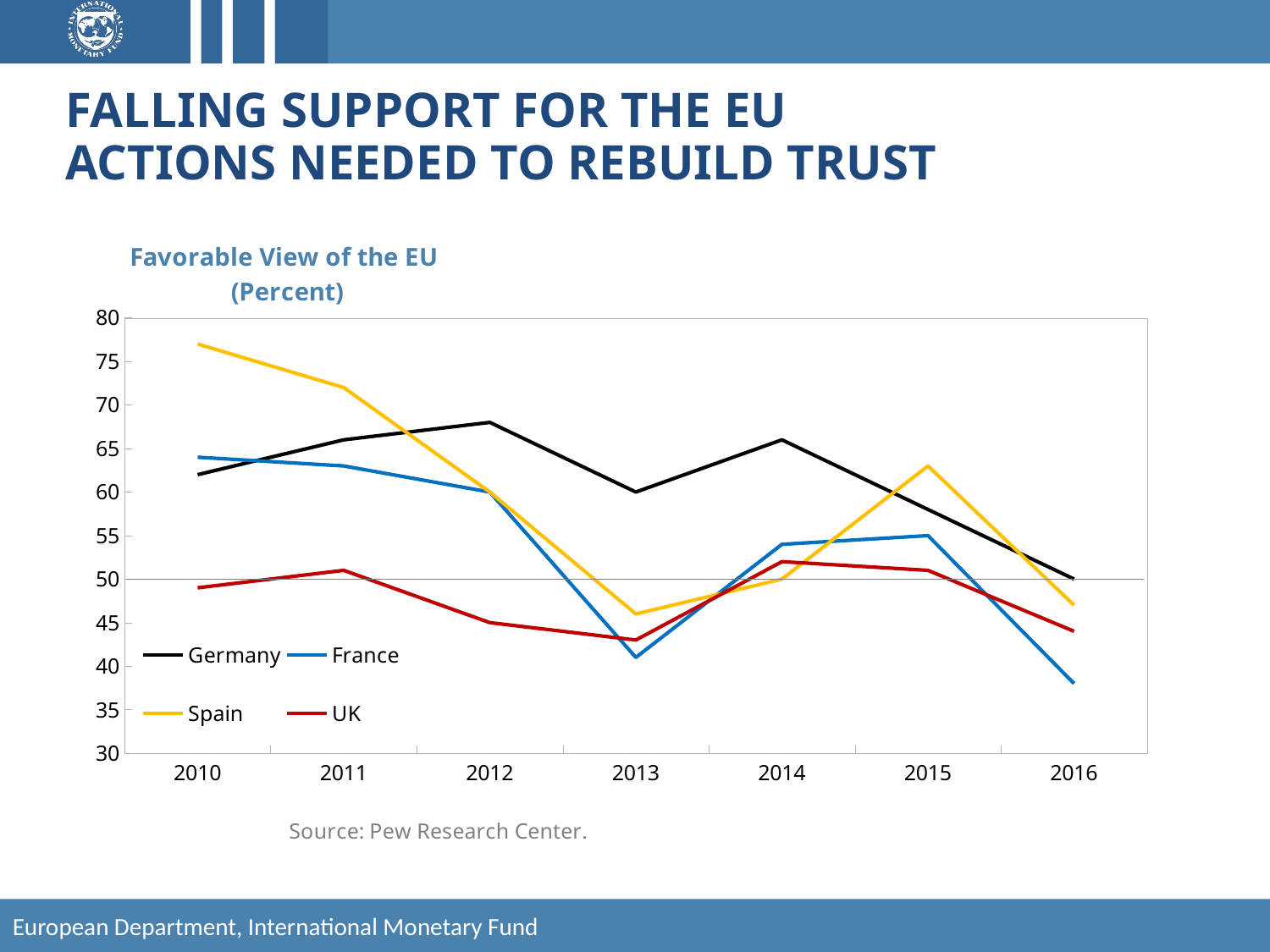
What is the source cited for the chart? Pew Research Center Is the value for Germany in 2012 greater or less than 65? greater Which country had the lowest favorable view of the EU in 2016? France Does the value for Spain rise or fall from 2010 to 2013? fall How many series does the legend list? 4 How many years are shown on the x axis? 7 In 2014, which is larger, the value for Germany or the value for UK? Germany Is the value for France in 2016 greater or less than 40? less Is the value for France in 2013 greater or less than 45? less Which country had the highest favorable view of the EU in 2010? Spain What kind of chart is shown on the slide? line chart